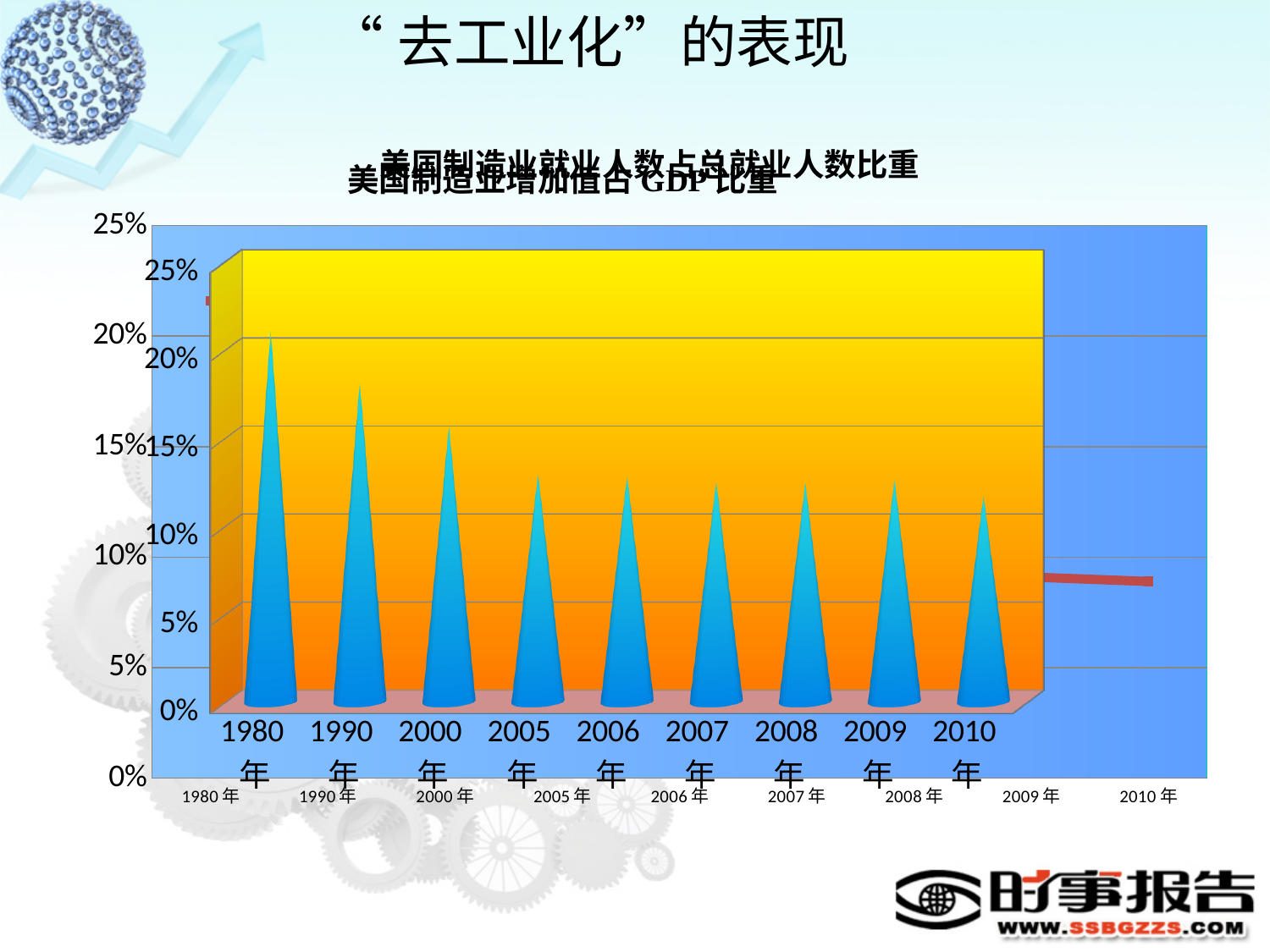
On the chart titled 美国制造业就业人数占总就业人数比重 (the cone chart in front), is the value for 2005年 greater or less than 10%? greater On the chart titled 美国制造业就业人数占总就业人数比重 (the cone chart in front), which year has the lowest value? 2010年 On the chart titled 美国制造业就业人数占总就业人数比重 (the cone chart in front), which is larger, the value for 1990年 or the value for 2010年? 1990年 On the chart titled 美国制造业就业人数占总就业人数比重 (the cone chart in front), is the value for 1980年 greater or less than 15%? greater On the chart titled 美国制造业就业人数占总就业人数比重 (the cone chart in front), is the value for 1980年 greater or less than 25%? less On the chart titled 美国制造业就业人数占总就业人数比重 (the cone chart in front), which is larger, the value for 1980年 or the value for 2000年? 1980年 On the chart titled 美国制造业就业人数占总就业人数比重 (the cone chart in front), how many years are shown on the x axis? 9 On the chart titled 美国制造业就业人数占总就业人数比重 (the cone chart in front), do the values generally rise or fall from 1980年 to 2010年? fall What kind of chart is the front chart titled 美国制造业就业人数占总就业人数比重? bar chart On the chart titled 美国制造业就业人数占总就业人数比重 (the cone chart in front), which year has the highest value? 1980年